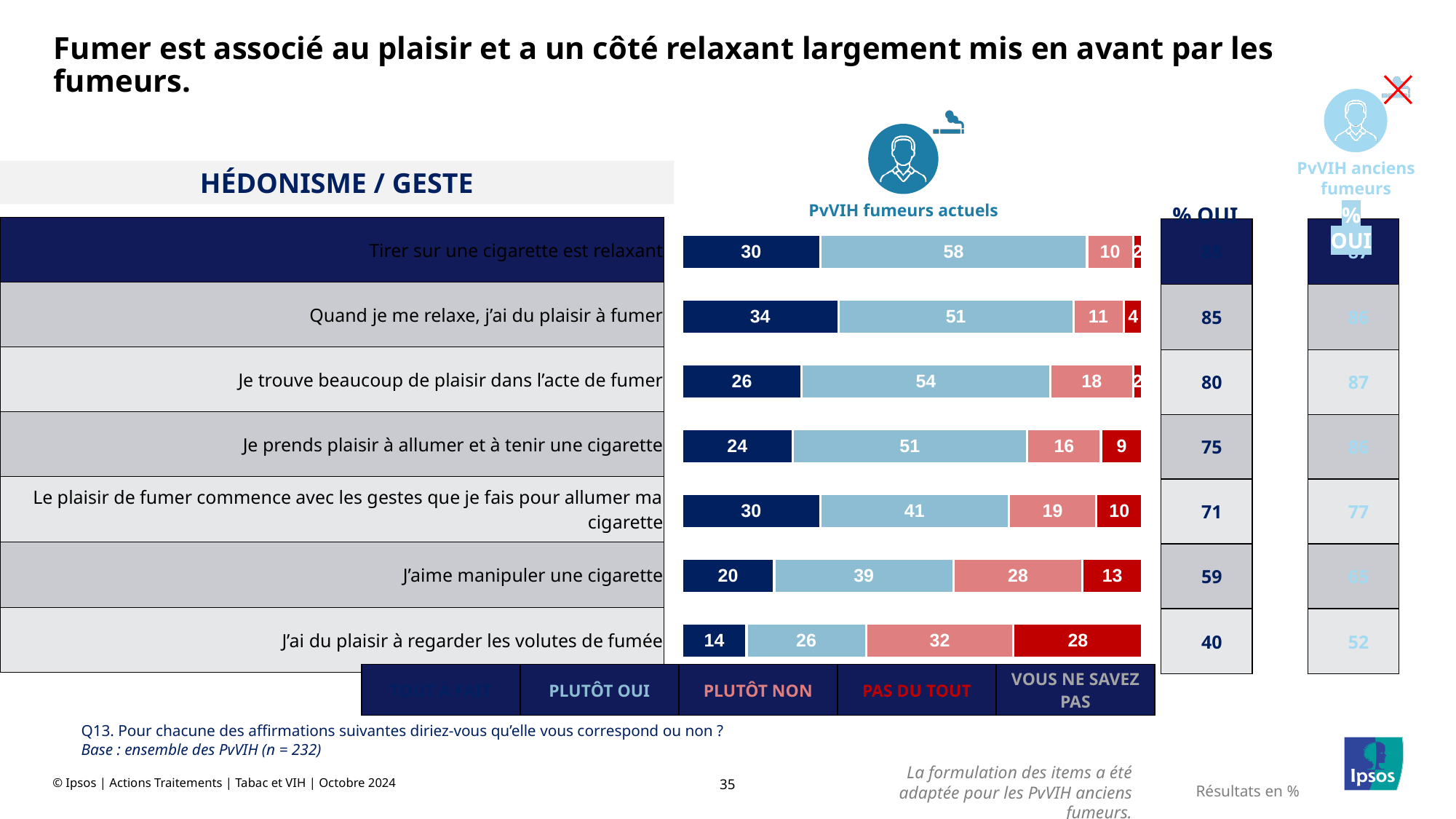
How many response categories does the legend list? 5 What is the "% OUI" value for PvVIH fumeurs actuels for "Je prends plaisir à allumer et à tenir une cigarette"? 75 Which statement has the lowest "Tout à fait" value? J'ai du plaisir à regarder les volutes de fumée What is the value of "Pas du tout" for "J'ai du plaisir à regarder les volutes de fumée"? 28 How many statements are plotted in the chart? 7 What is the difference between the "Plutôt non" values for "J'aime manipuler une cigarette" and "Je prends plaisir à allumer et à tenir une cigarette"? 12 Which statement has the highest "Pas du tout" value? J'ai du plaisir à regarder les volutes de fumée Which has the larger "Tout à fait" value: "Tirer sur une cigarette est relaxant" or "Je trouve beaucoup de plaisir dans l'acte de fumer"? Tirer sur une cigarette est relaxant What is the value of "Tout à fait" for "Quand je me relaxe, j'ai du plaisir à fumer"? 34 What is the value of "Plutôt oui" for "Tirer sur une cigarette est relaxant"? 58 What kind of chart is shown on the slide? Stacked bar chart What is the combined value of "Tout à fait" and "Plutôt oui" for "J'aime manipuler une cigarette"? 59